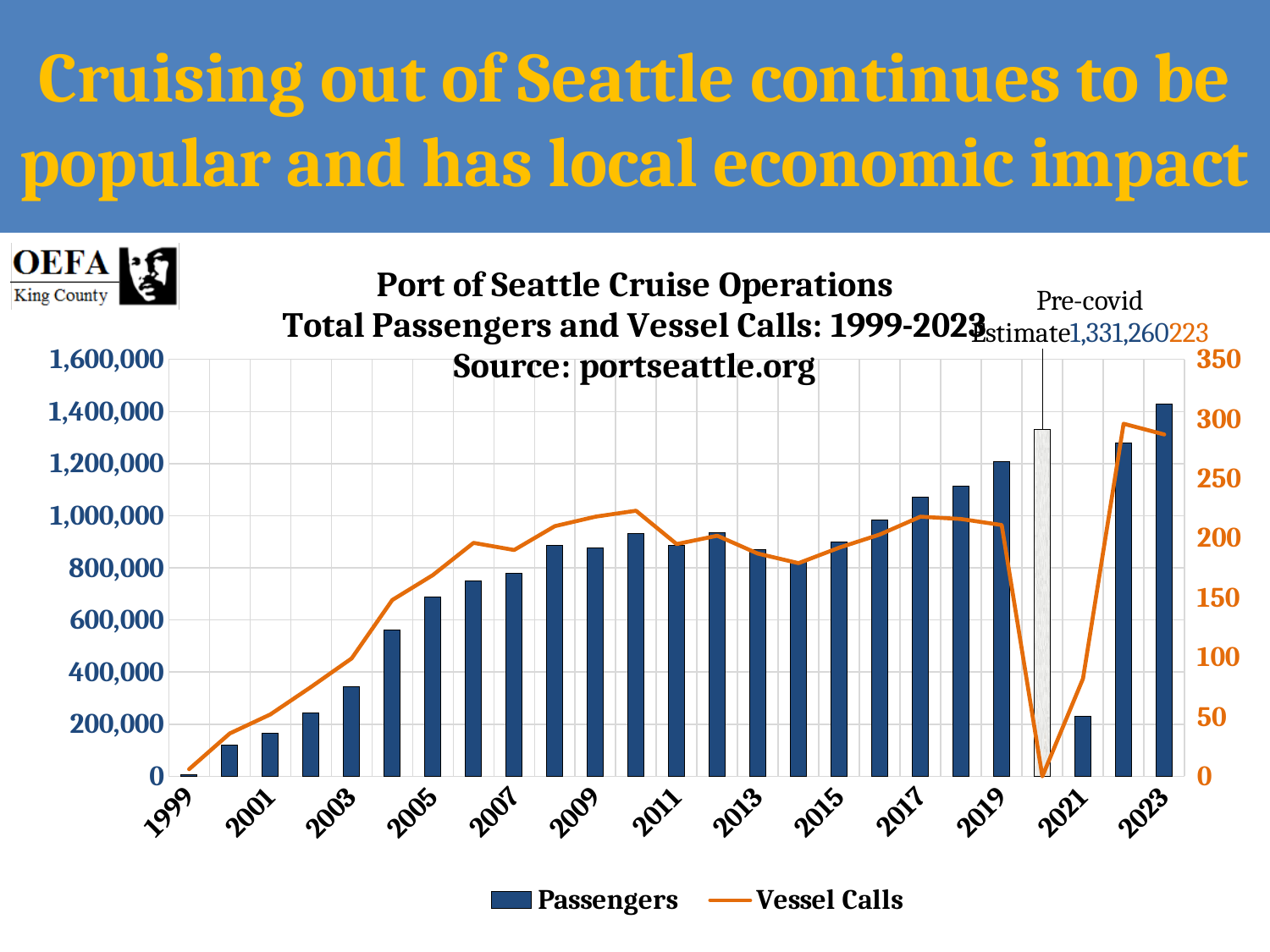
Do passengers generally rise or fall from 1999 to 2009? rise What is the pre-covid estimate of passengers labelled for 2020? 1,331,260 Is the Vessel Calls value for 2021 greater or less than 100? less What kind of chart is shown on the slide? A bar chart combined with a line chart Is the Passengers value for 2019 greater or less than 1,000,000? greater Which year has the lowest Passengers bar? 1999 Is the Passengers value for 2021 greater or less than 400,000? less What are the two series named in the legend? Passengers and Vessel Calls Which year has the highest Passengers bar? 2023 What is the pre-covid estimate of vessel calls labelled for 2020? 223 Which year has more passengers, 2013 or 2017? 2017 How many series does the legend list? 2